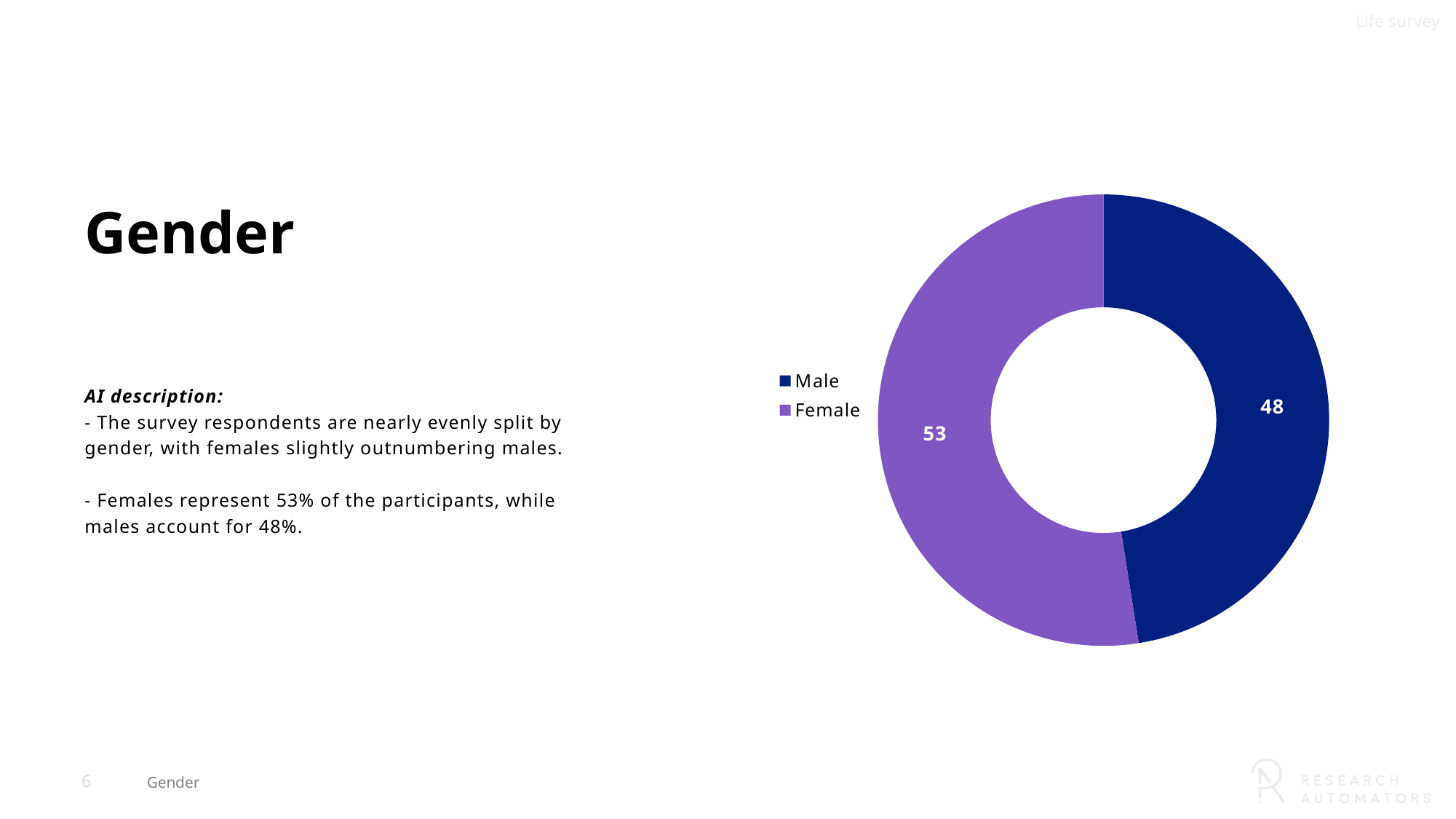
Which category has the smaller value in the chart? Male What is the value shown for Female in the donut chart? 53 What kind of chart is shown on the slide? Donut (pie) chart Is the value for Female larger or smaller than the value for Male? larger Which category has the larger value in the chart? Female How many entries does the legend list? 2 What is the total of the two values shown in the chart? 101 What is the title of the slide containing the chart? Gender What is the difference between the Female and Male values? 5 Which colour represents Male in the chart? Dark blue What is the value shown for Male in the donut chart? 48 How many categories does the chart show? 2